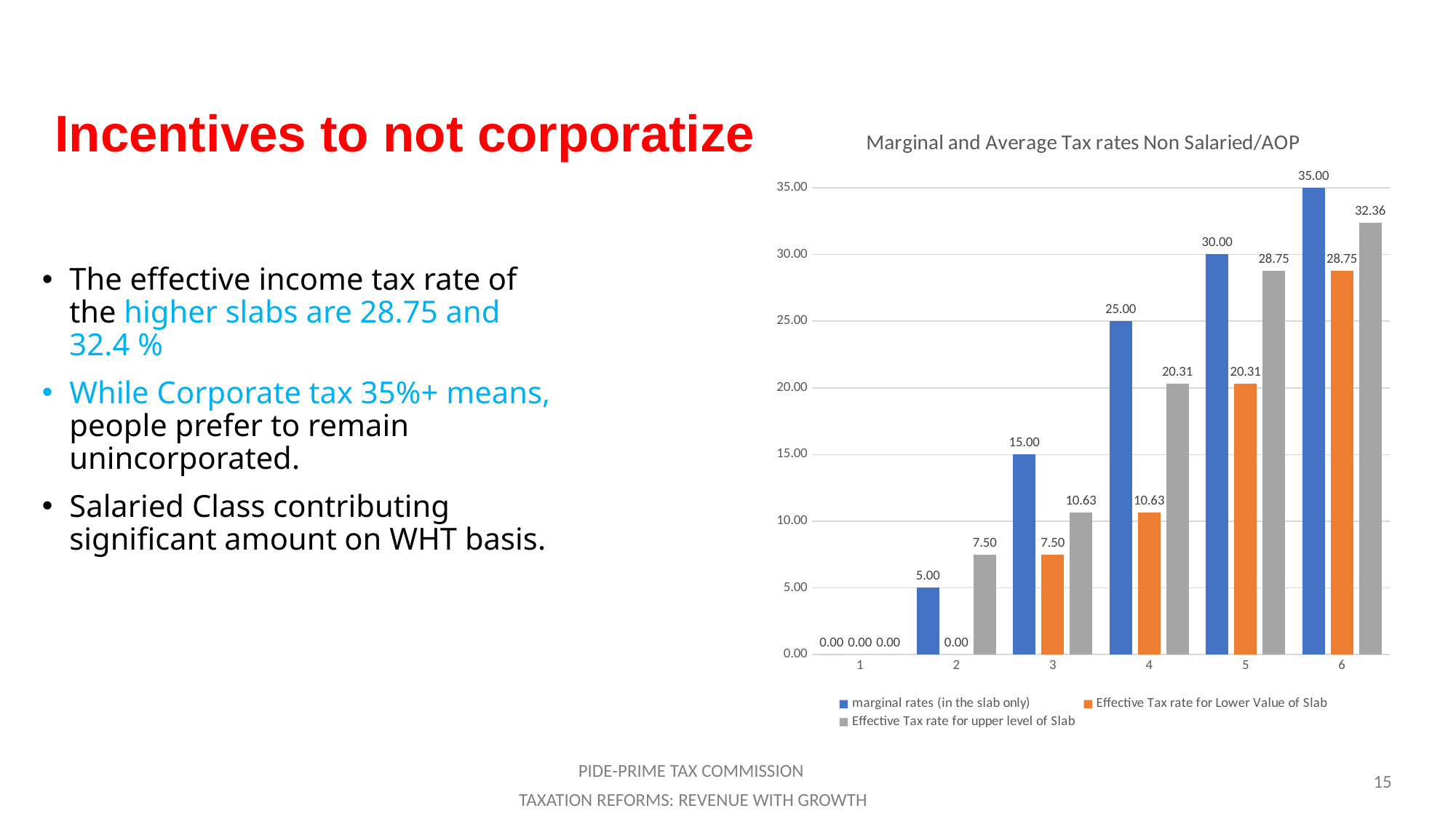
What type of chart is shown on the slide? Bar chart What is the Effective Tax rate for upper level of Slab for category 4? 20.31 Which is larger for category 5: the marginal rate (in the slab only) or the Effective Tax rate for Lower Value of Slab? marginal rates (in the slab only) Do the marginal rates (in the slab only) rise or fall from category 1 to category 6? Rise What is the marginal rate (in the slab only) for category 6? 35.00 What is the title of the chart? Marginal and Average Tax rates Non Salaried/AOP What is the Effective Tax rate for Lower Value of Slab for category 3? 7.50 How many categories are shown on the x axis of the chart? 6 Which category has the highest Effective Tax rate for upper level of Slab? 6 What is the difference between the marginal rate and the Effective Tax rate for upper level of Slab for category 6? 2.64 What is the Effective Tax rate for Lower Value of Slab for category 2? 0.00 How many series does the chart legend list? 3